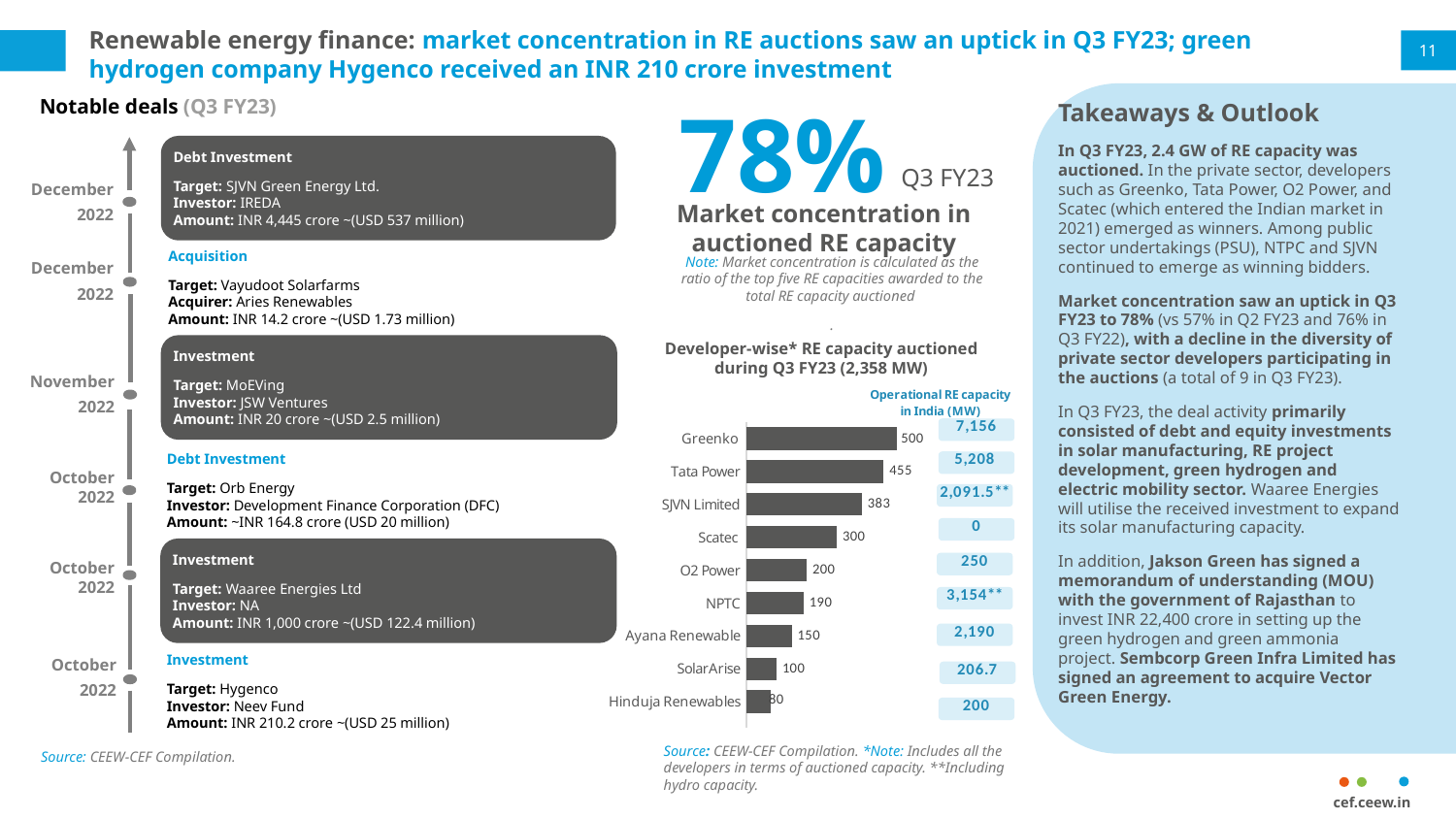
What kind of chart is used to show developer-wise RE capacity auctioned during Q3 FY23? Bar chart In the developer-wise RE capacity auctioned chart, which is larger: Scatec or O2 Power? Scatec Which developer has the highest RE capacity auctioned in the developer-wise chart? Greenko In the developer-wise RE capacity auctioned chart, what is the value for SJVN Limited? 383 What total auctioned capacity is stated in the title of the developer-wise RE capacity chart? 2,358 MW In the developer-wise RE capacity auctioned chart, what is the value for Greenko? 500 In the developer-wise RE capacity auctioned chart, what is the difference between Greenko and Tata Power? 45 In the developer-wise RE capacity auctioned chart, what is the value for NPTC? 190 In the developer-wise RE capacity auctioned chart, what is the value for Ayana Renewable? 150 In the developer-wise RE capacity auctioned chart, what is the operational RE capacity in India (MW) listed next to Tata Power? 5,208 How many developers are shown in the developer-wise RE capacity auctioned chart? 9 Which developer has the lowest RE capacity auctioned in the developer-wise chart? Hinduja Renewables